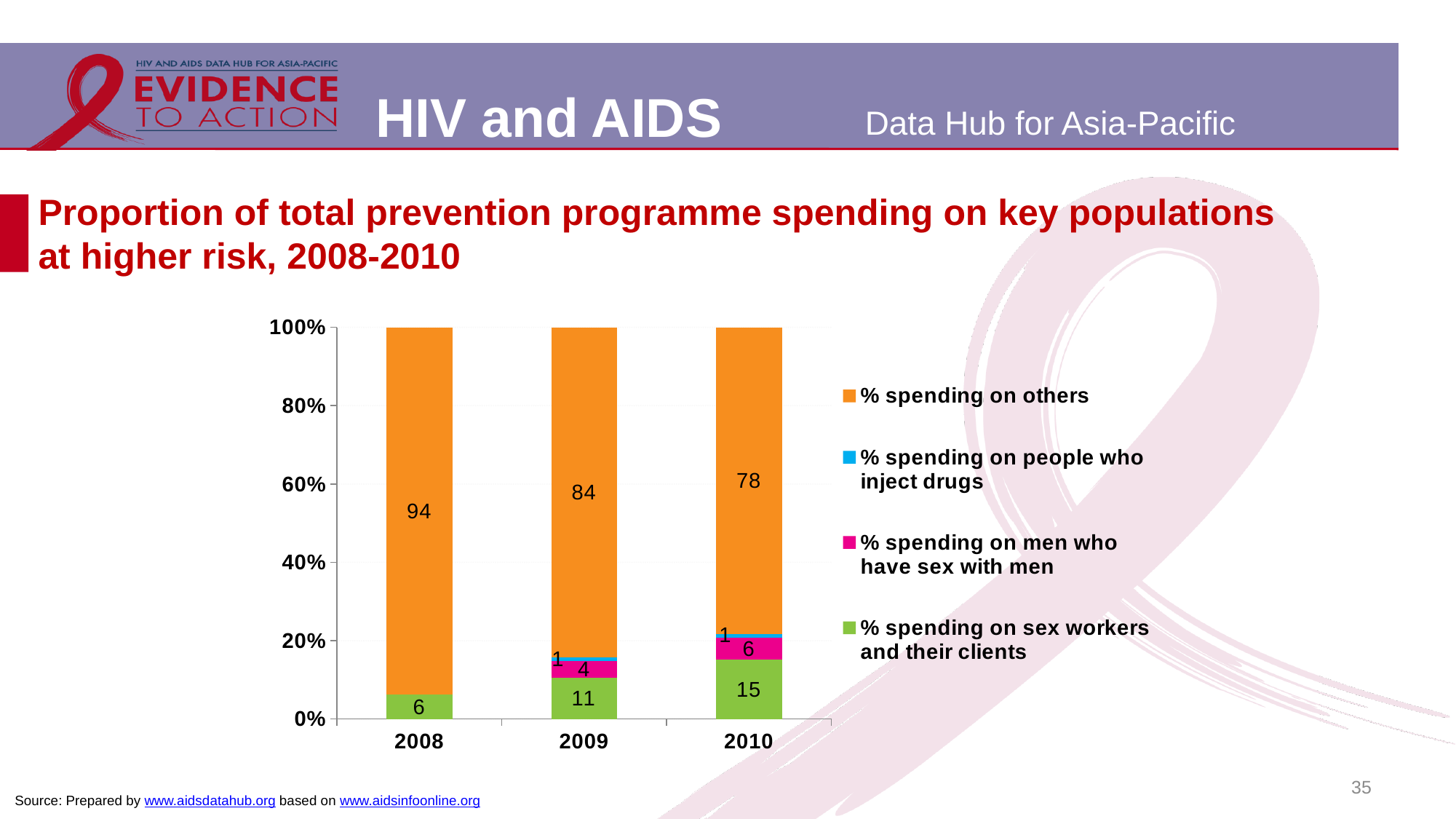
What is the difference between % spending on others in 2008 and in 2010? 16 How many series does the legend list? 4 What is the value for % spending on others in 2008? 94 What is the value for % spending on people who inject drugs in 2010? 1 What is the value for % spending on sex workers and their clients in 2010? 15 Which is larger: % spending on men who have sex with men in 2009 or in 2010? 2010 What is the value for % spending on men who have sex with men in 2009? 4 In which year is % spending on sex workers and their clients the highest? 2010 What type of chart is shown on the slide? stacked bar chart Does % spending on sex workers and their clients rise or fall from 2008 to 2010? rise How many years are shown on the x axis of the chart? 3 In which year is % spending on others the lowest? 2010